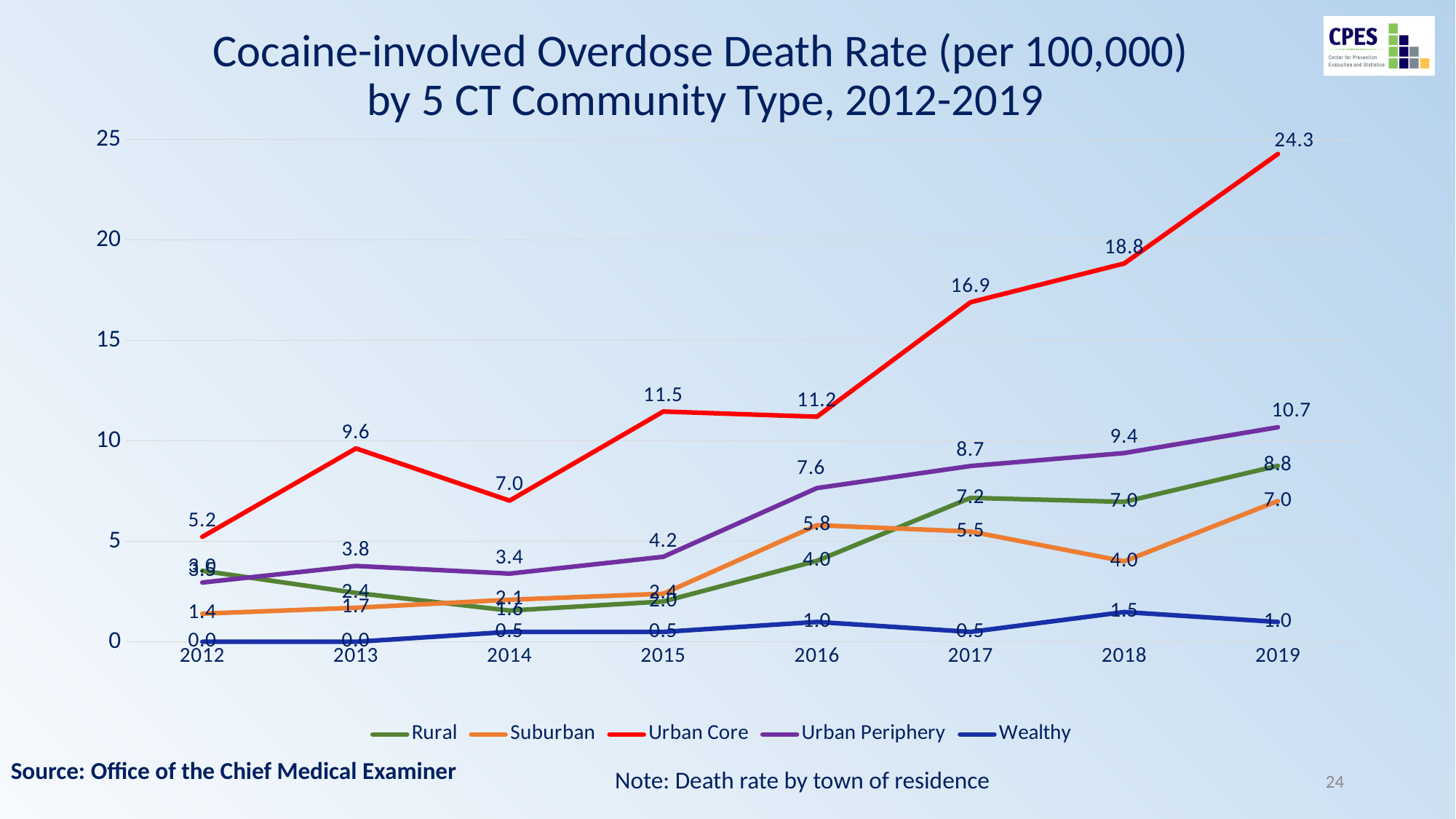
What is the Wealthy value in 2018? 1.5 By how much did the Urban Core rate increase from 2018 to 2019? 5.5 How many years are shown on the x axis? 8 In 2019, which is higher: Rural or Suburban? Rural Is the Urban Core value for 2017 greater or less than 15? greater Which community type has the lowest value in 2019? Wealthy How many series does the legend list? 5 What is the Urban Core cocaine-involved overdose death rate in 2019? 24.3 What is the Suburban value in 2016? 5.8 What kind of chart is shown on the slide? Line chart What is the Urban Periphery value in 2019? 10.7 In which year does the Urban Core series reach its highest value? 2019